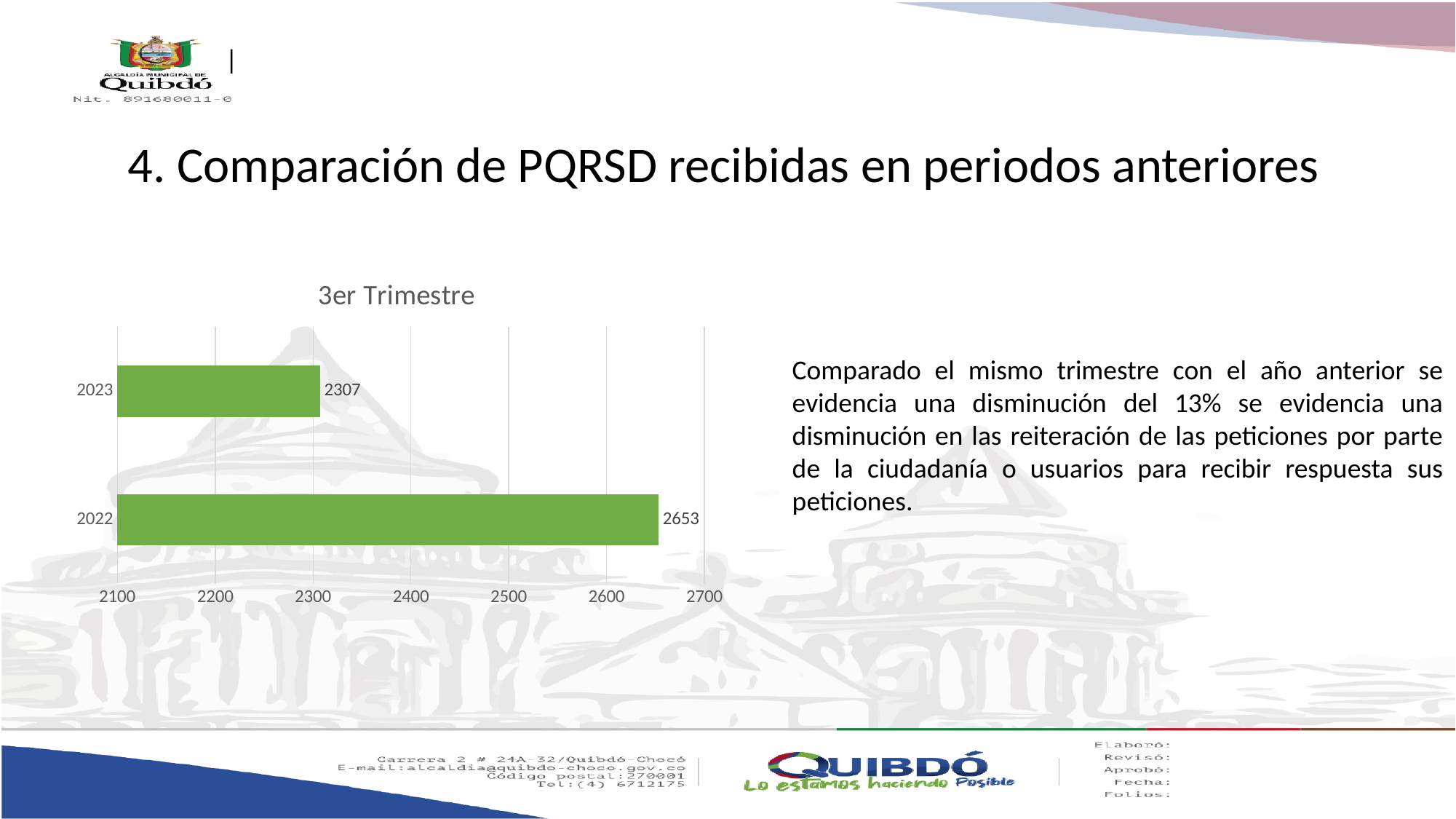
How many categories are shown in the chart? 2 What is the difference between the values for 2022 and 2023? 346 Which year has the lowest value in the chart? 2023 Is the value for 2022 greater or less than 2600? greater What is the value for 2023 in the chart? 2307 What kind of chart is shown on the slide? bar chart What is the value for 2022 in the chart? 2653 Which year has the highest value in the chart? 2022 Is the value for 2023 greater or less than 2400? less Which is larger, the value for 2022 or the value for 2023? 2022 What colour are the bars in the chart? green What is the title of the chart? 3er Trimestre